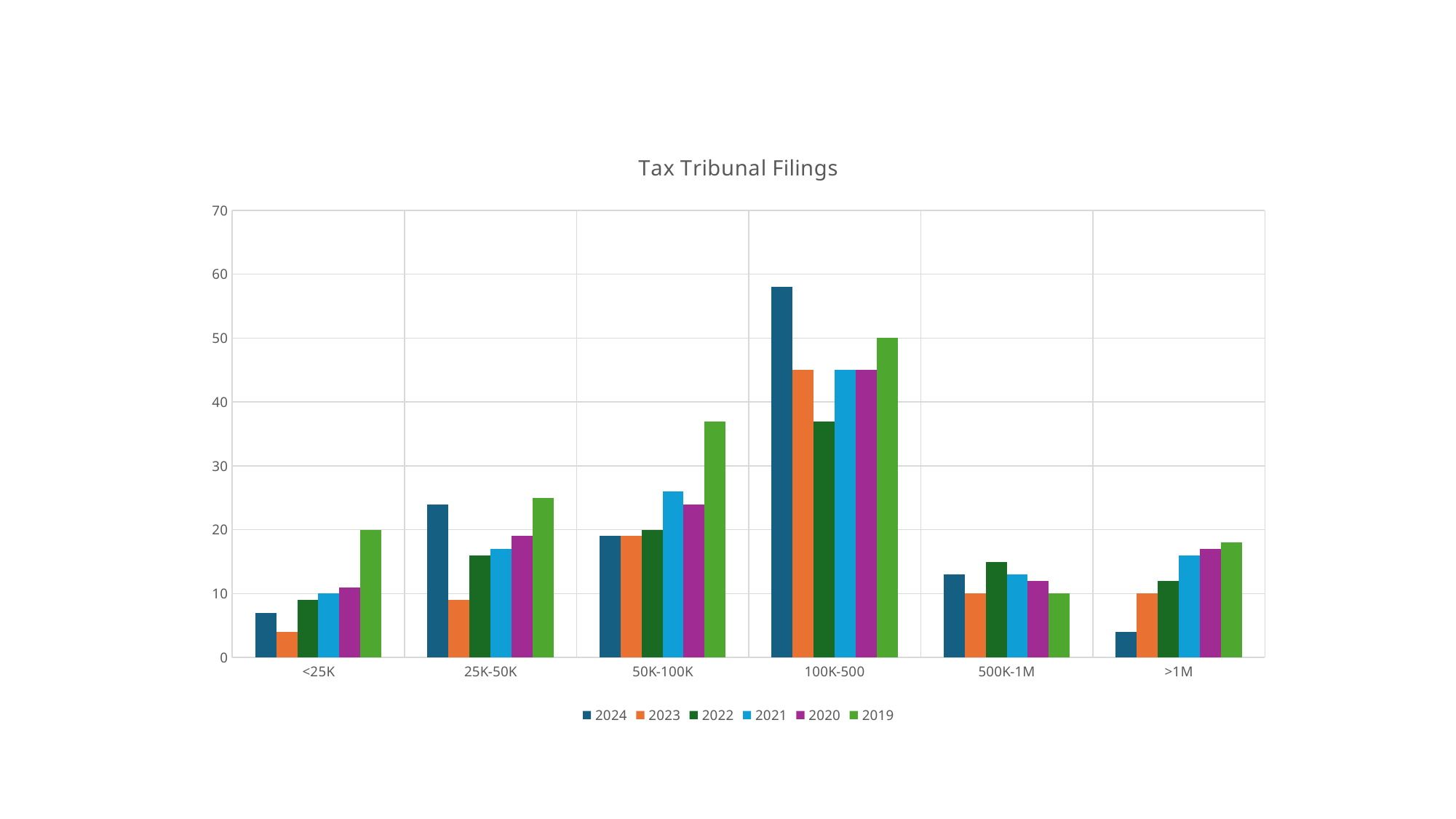
Which category has the lowest value for 2024? >1M Is the value for 2024 in the 100K-500 category greater or less than 50? greater What is the value for 2023 in the 500K-1M category? 10 Is the value for 2019 in the 50K-100K category greater or less than 30? greater How many categories are shown on the x axis? 6 How many series does the legend list? 6 What is the value for 2019 in the <25K category? 20 What is the value for 2019 in the 100K-500 category? 50 What type of chart is shown on the slide? bar chart Which is larger in the 25K-50K category, the value for 2024 or the value for 2023? 2024 Which category has the highest value for 2024? 100K-500 What is the title of the chart? Tax Tribunal Filings